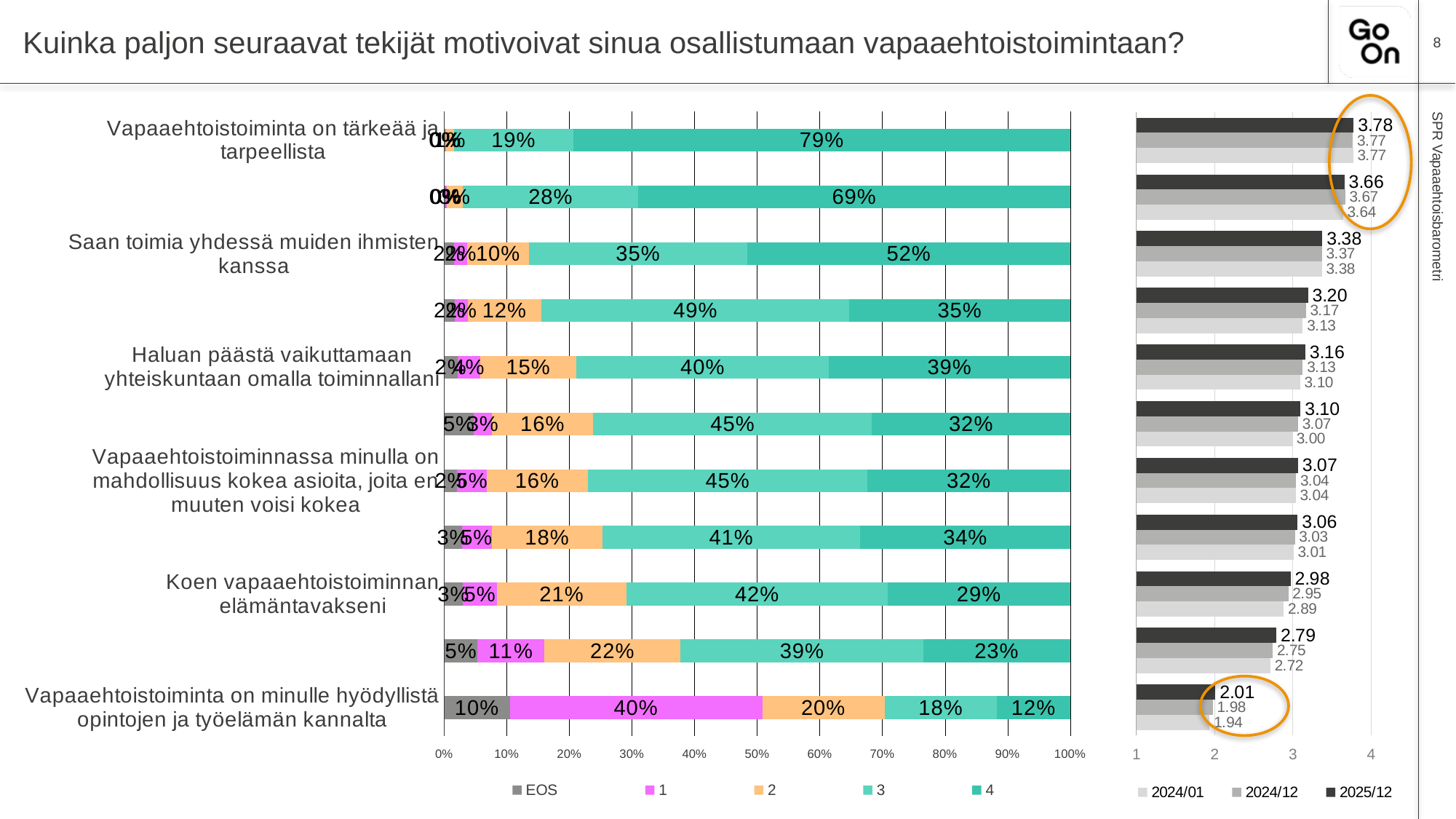
In the right chart, what is the 2025/12 value for "Vapaaehtoistoiminta on tärkeää ja tarpeellista"? 3.78 How many series does the legend of the left stacked bar chart list? 5 In the right chart, which statement has the lowest 2025/12 value? Vapaaehtoistoiminta on minulle hyödyllistä opintojen ja työelämän kannalta In the left stacked bar chart, what percentage of respondents gave a rating of 4 for "Vapaaehtoistoiminta on tärkeää ja tarpeellista"? 79% How many bars (statements) are shown in the left stacked bar chart? 11 What type of chart is the left chart on the slide? Stacked bar chart How many series does the legend of the right chart list? 3 In the left stacked bar chart, what is the difference between the share rating 4 and the share rating 3 for "Vapaaehtoistoiminta on tärkeää ja tarpeellista"? 60% In the left stacked bar chart, what percentage gave a rating of 1 for "Vapaaehtoistoiminta on minulle hyödyllistä opintojen ja työelämän kannalta"? 40% In the left stacked bar chart, what percentage gave a rating of 3 for "Haluan päästä vaikuttamaan yhteiskuntaan omalla toiminnallani"? 40% In the right chart, what is the 2024/01 value for "Vapaaehtoistoiminta on minulle hyödyllistä opintojen ja työelämän kannalta"? 1.94 In the left stacked bar chart, what percentage gave a rating of 3 for "Saan toimia yhdessä muiden ihmisten kanssa"? 35%